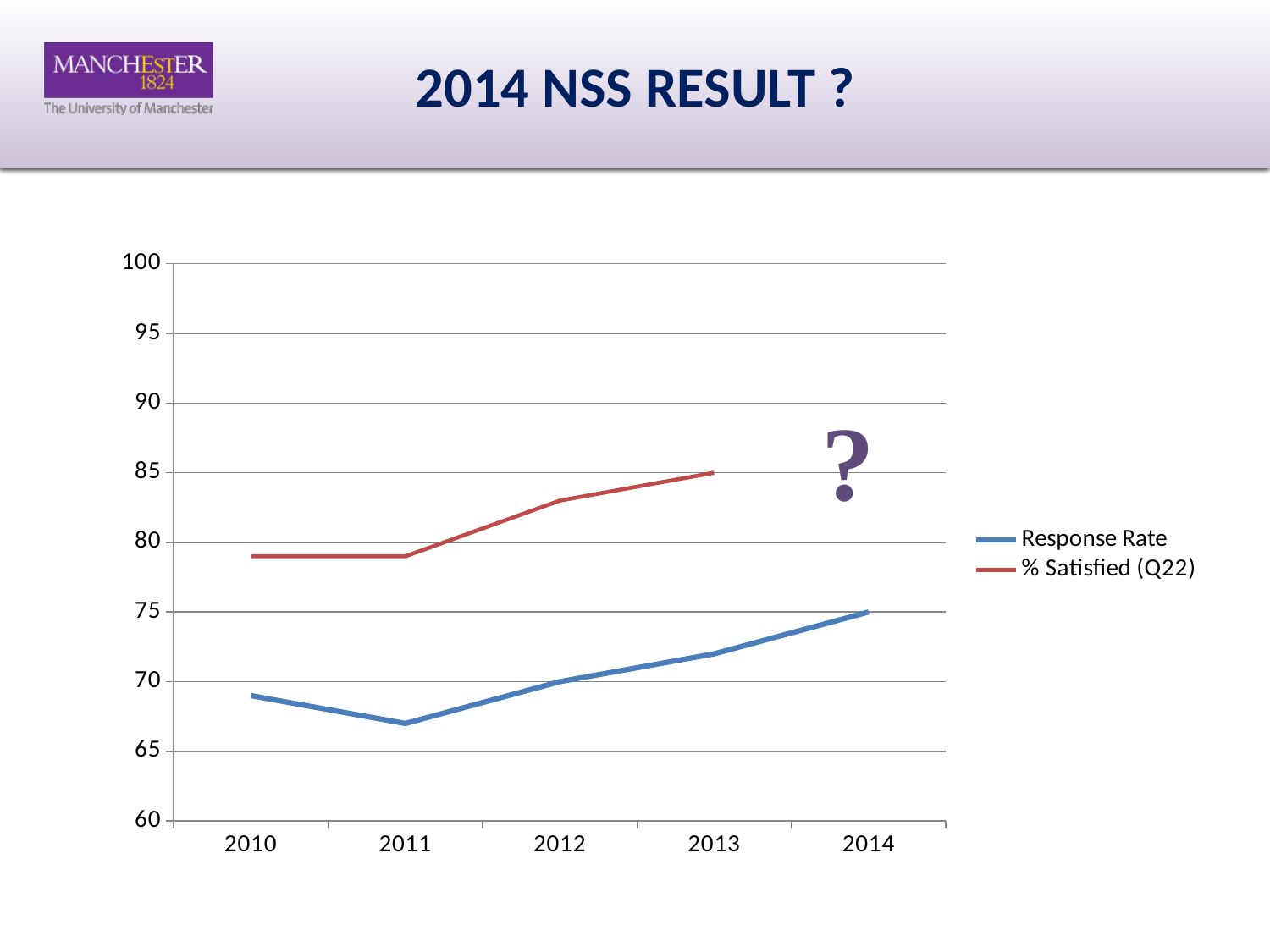
In 2013, which is larger: the Response Rate or % Satisfied (Q22)? % Satisfied (Q22) What is the Response Rate value for 2014? 75 What is the % Satisfied (Q22) value for 2013? 85 Is the Response Rate for 2011 greater or less than 70? less How many years are shown on the x axis? 5 In which year is the Response Rate highest? 2014 Is the % Satisfied (Q22) value for 2012 greater or less than 80? greater What kind of chart is shown on the slide? line chart Does the Response Rate rise or fall from 2011 to 2014? rise Is the % Satisfied (Q22) value for 2010 greater or less than 80? less How many series does the legend list? 2 In which year is the Response Rate lowest? 2011